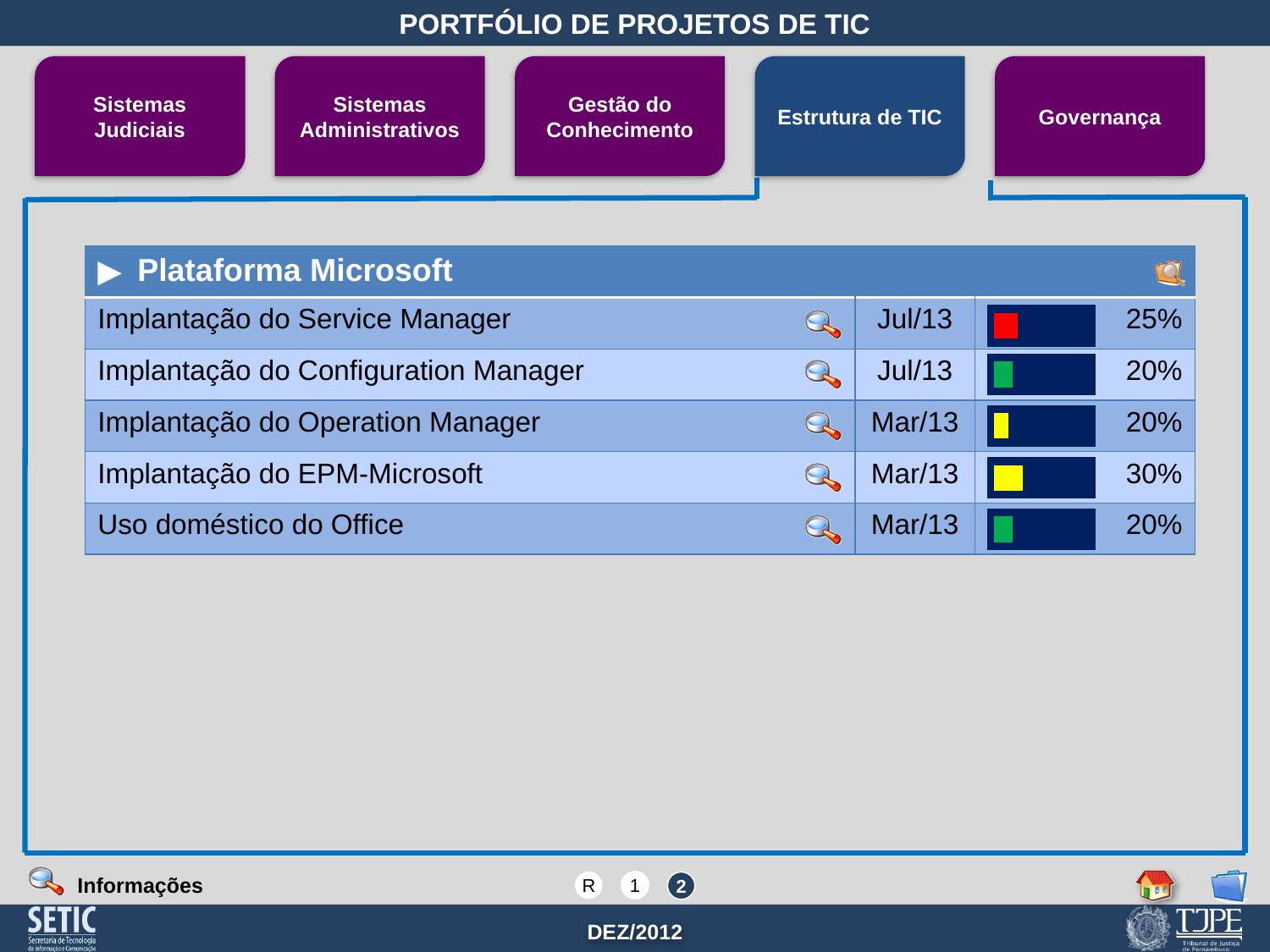
What is the difference in completion percentage between Implantação do EPM-Microsoft and Implantação do Service Manager? 5% Which project has the highest completion percentage? Implantação do EPM-Microsoft What date is shown for Implantação do Service Manager? Jul/13 What kind of chart is used to show each project's completion? Bar chart What completion percentage is shown for Uso doméstico do Office? 20% How many projects are listed under Plataforma Microsoft? 5 What date is shown for Implantação do EPM-Microsoft? Mar/13 What is the title of the project group shown on the slide? Plataforma Microsoft What completion percentage is shown for Implantação do Configuration Manager? 20% Which has a higher completion percentage, Implantação do Service Manager or Implantação do Configuration Manager? Implantação do Service Manager What completion percentage is shown for Implantação do EPM-Microsoft? 30% What completion percentage is shown for Implantação do Service Manager? 25%